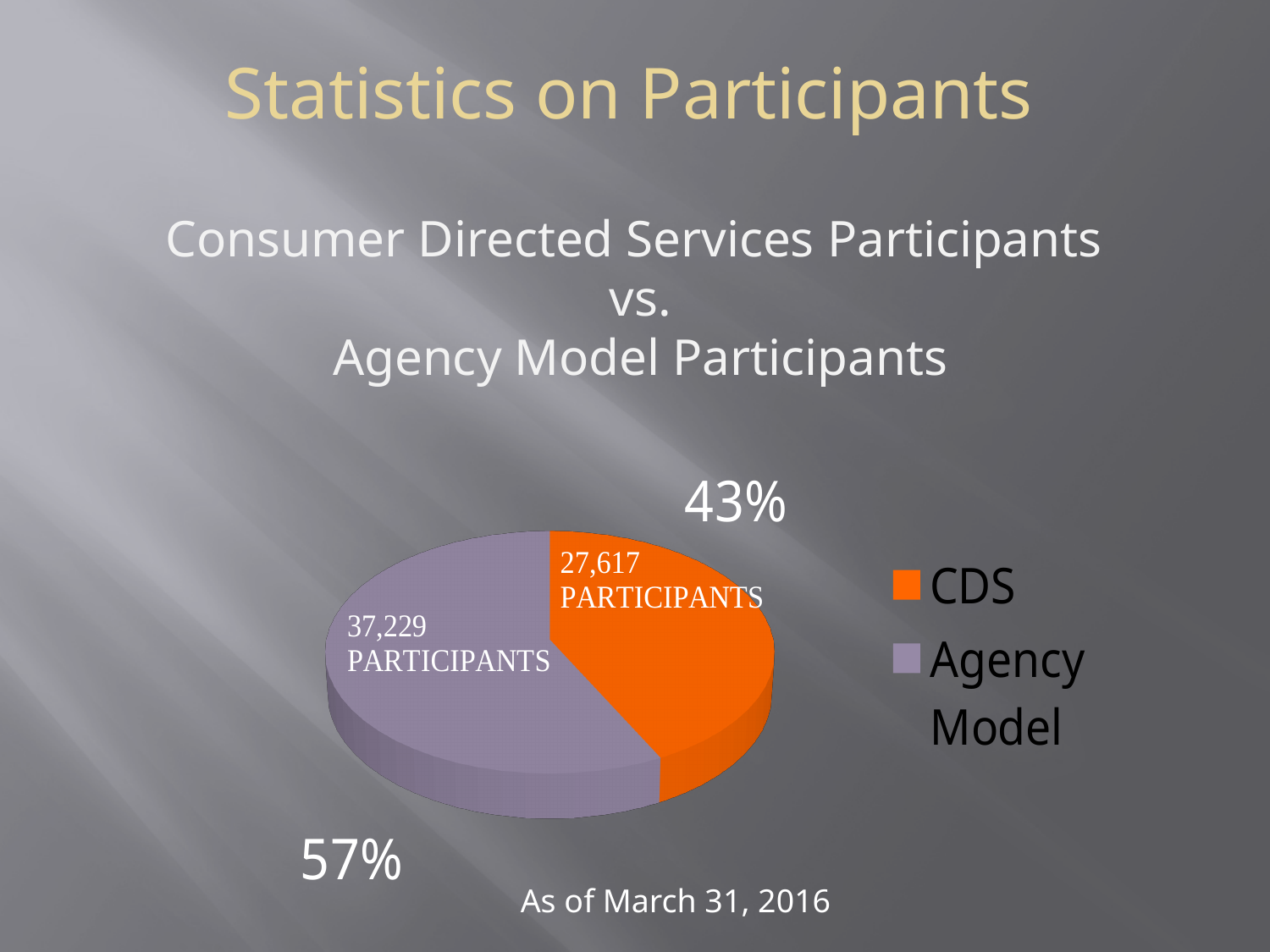
How many participants are in the Agency Model slice of the pie chart? 37,229 What colour is the CDS slice in the pie chart? Orange What kind of chart is shown on the slide? Pie chart What percentage share of the pie does the Agency Model slice represent? 57% How many participants are in the CDS slice of the pie chart? 27,617 How many entries does the legend of the pie chart list? 2 What percentage share of the pie does the CDS slice represent? 43% What is the difference in participants between the Agency Model and CDS slices? 9,612 Which slice of the pie chart is the smallest? CDS Which slice of the pie chart is the largest? Agency Model Which has more participants, CDS or Agency Model? Agency Model How many slices does the pie chart have? 2